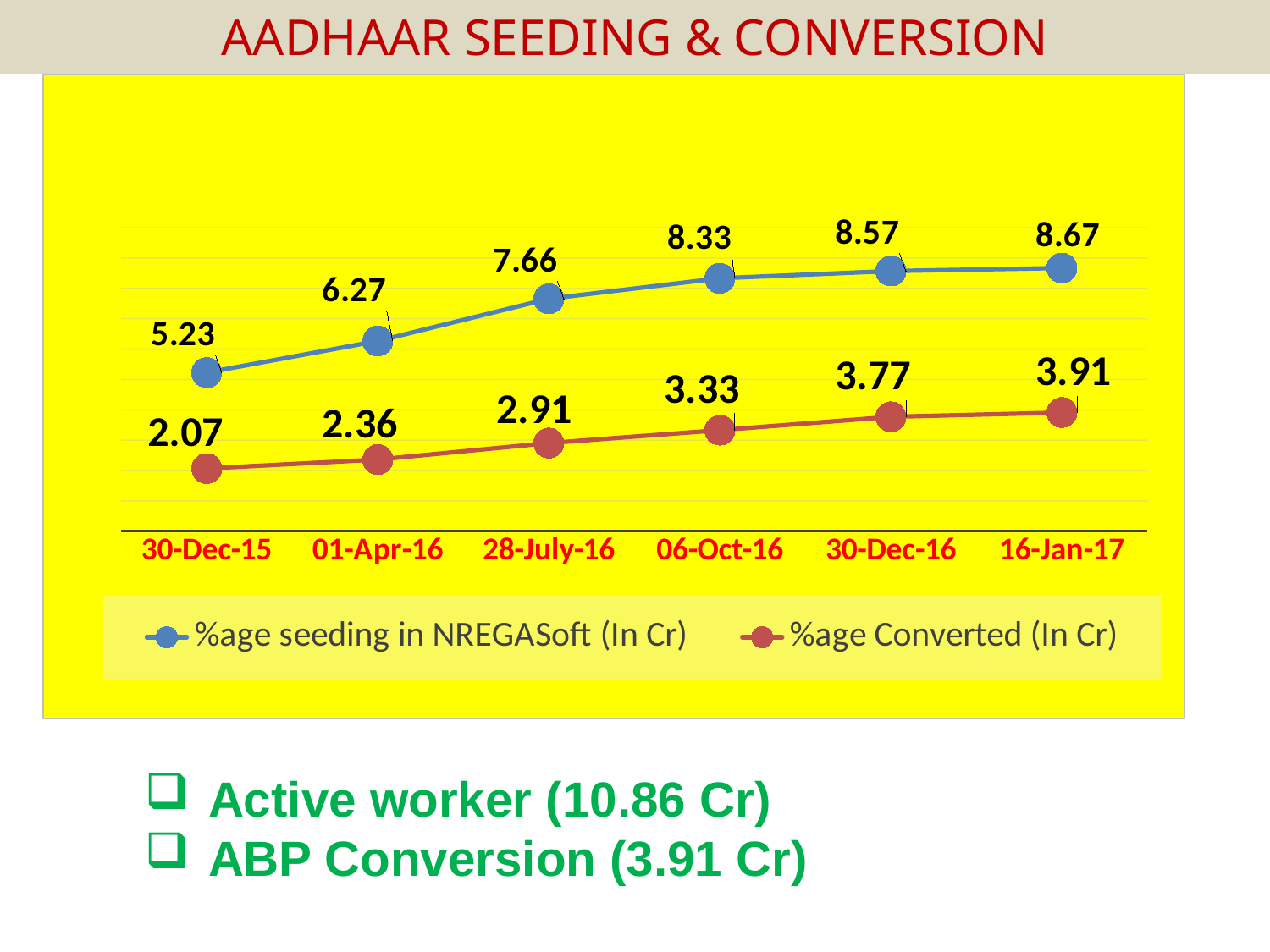
On which date is %age seeding in NREGASoft (In Cr) lowest? 30-Dec-15 What is the value of %age seeding in NREGASoft (In Cr) on 28-July-16? 7.66 How many series does the chart legend list? 2 What is the difference between %age seeding in NREGASoft (In Cr) and %age Converted (In Cr) on 16-Jan-17? 4.76 What kind of chart is shown on the slide? Line chart What is the value of %age Converted (In Cr) on 06-Oct-16? 3.33 How many dates are shown on the x axis of the chart? 6 On which date is %age Converted (In Cr) highest? 16-Jan-17 Does %age seeding in NREGASoft (In Cr) rise or fall from 30-Dec-15 to 16-Jan-17? Rise What is the value of %age seeding in NREGASoft (In Cr) on 30-Dec-15? 5.23 Which is larger: %age seeding in NREGASoft (In Cr) on 01-Apr-16 or %age Converted (In Cr) on 16-Jan-17? %age seeding in NREGASoft (In Cr) on 01-Apr-16 By how much did %age Converted (In Cr) increase from 30-Dec-15 to 30-Dec-16? 1.70